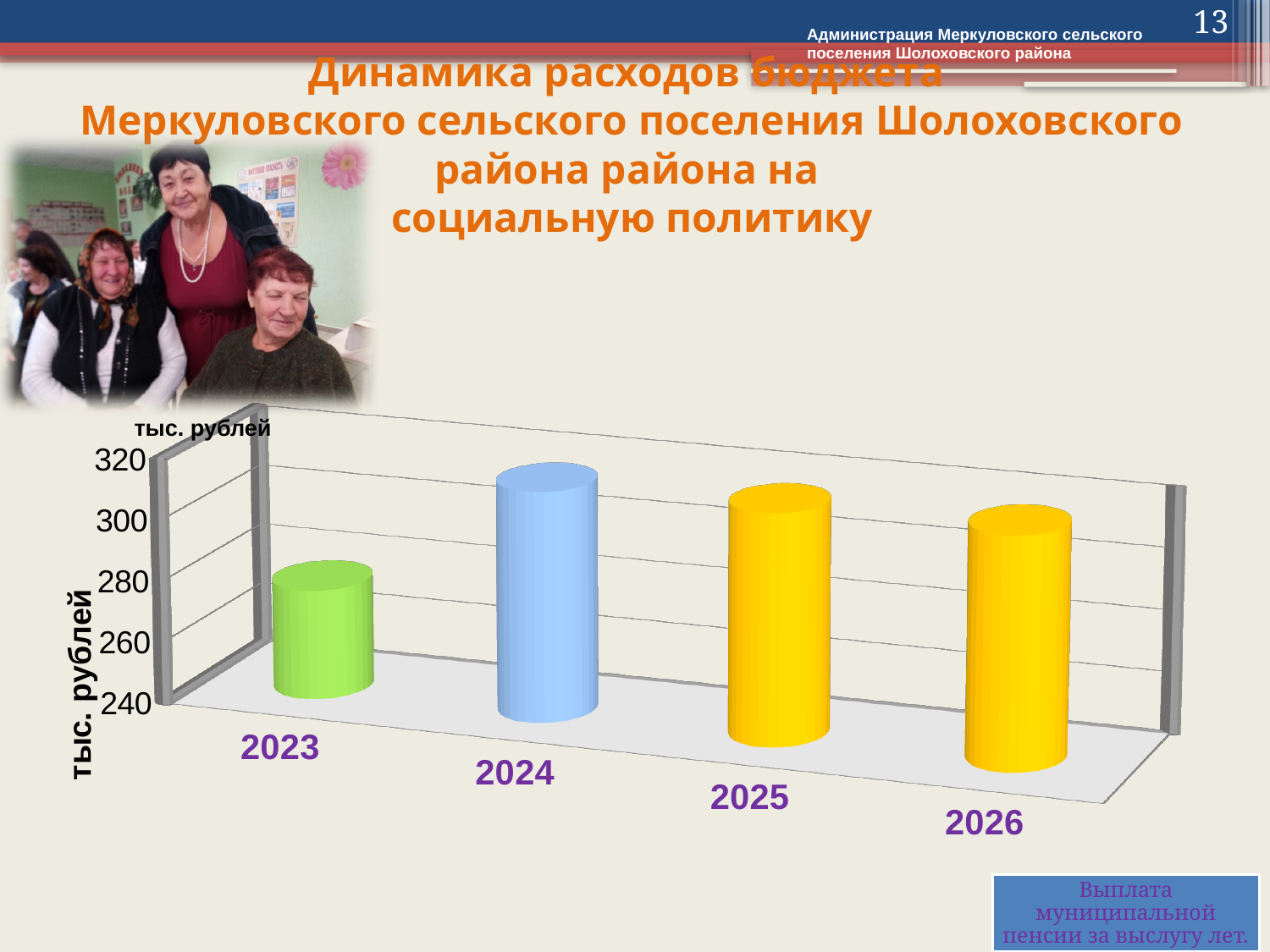
Is the value for 2024 greater or less than 300? greater Which year has the lowest value on the chart? 2023 What unit is shown on the vertical axis of the chart? тыс. рублей Which is larger, the value for 2023 or the value for 2026? 2026 Which is larger, the value for 2023 or the value for 2024? 2024 Is the value for 2026 greater or less than 300? greater What kind of chart is shown on the slide? bar chart Is the value for 2025 greater or less than 300? greater How many years (categories) are plotted on the chart? 4 What colour is the bar for 2023? green